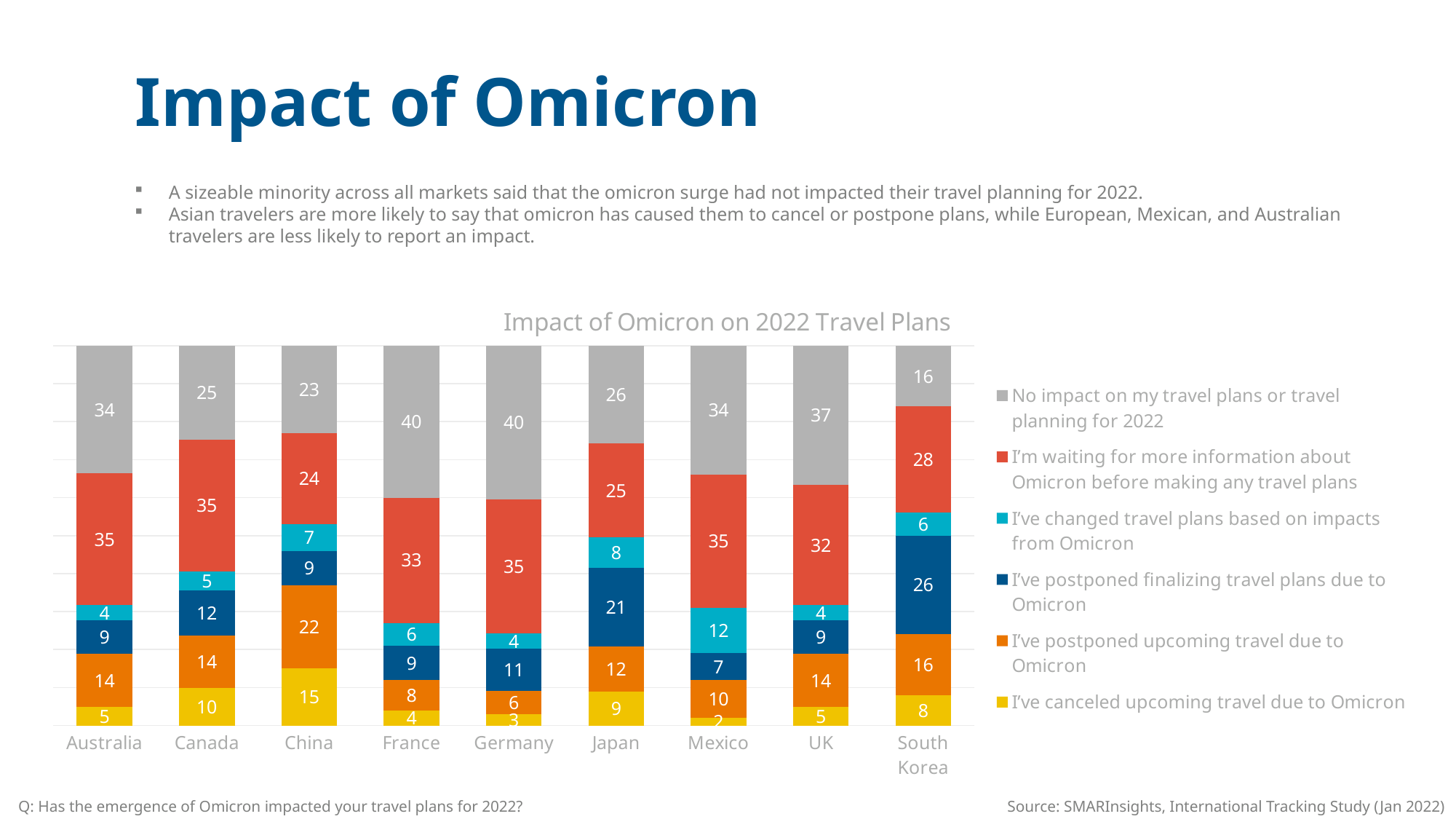
What is the value for 'I've changed travel plans based on impacts from Omicron' for Mexico? 12 Which country has the lowest value for 'I've canceled upcoming travel due to Omicron'? Mexico Which country has the lowest value for 'No impact on my travel plans or travel planning for 2022'? South Korea Which country has the highest value for 'I've postponed finalizing travel plans due to Omicron'? South Korea What is the value for 'No impact on my travel plans or travel planning for 2022' for France? 40 Which has the larger value for 'I'm waiting for more information about Omicron before making any travel plans', Canada or China? Canada What is the title of the chart? Impact of Omicron on 2022 Travel Plans What is the value for 'I've canceled upcoming travel due to Omicron' for China? 15 How many series does the chart's legend list? 6 What kind of chart is shown on the slide? Stacked bar chart What is the difference between Japan's and Australia's values for 'I've postponed finalizing travel plans due to Omicron'? 12 How many countries are shown on the x axis of the chart? 9